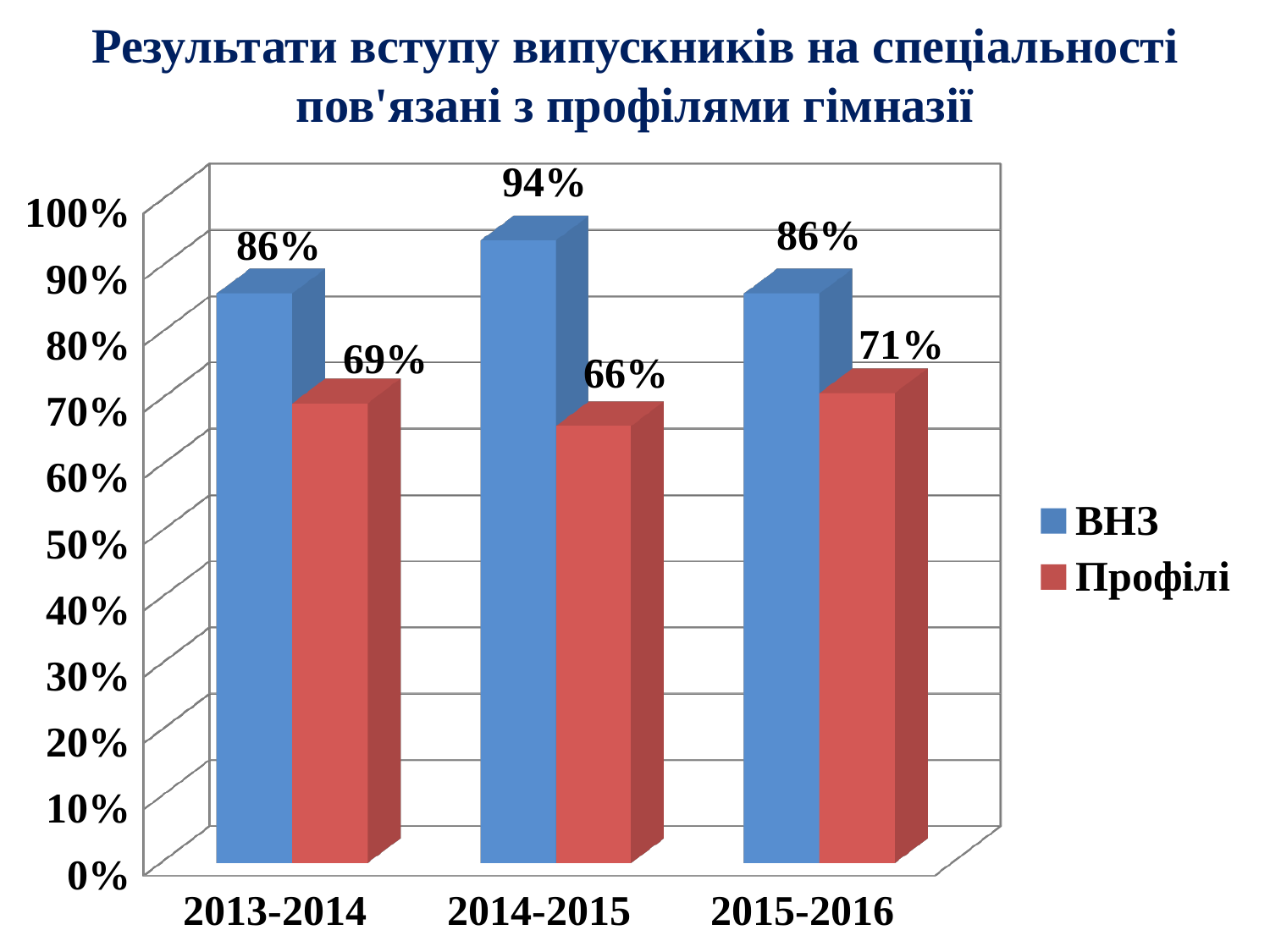
What is the value for Профілі in 2015-2016? 71% In which year is the Профілі value lowest? 2014-2015 Is the value for Профілі in 2013-2014 greater or less than 60%? greater How many series does the legend list? 2 What is the value for ВНЗ in 2014-2015? 94% How many year categories are shown on the x axis? 3 What is the value for Профілі in 2013-2014? 69% In which year is the ВНЗ value highest? 2014-2015 What kind of chart is shown on the slide? bar chart Which colour represents the ВНЗ series? blue Which is larger in 2015-2016, ВНЗ or Профілі? ВНЗ What is the difference between the ВНЗ and Профілі values in 2014-2015? 28%